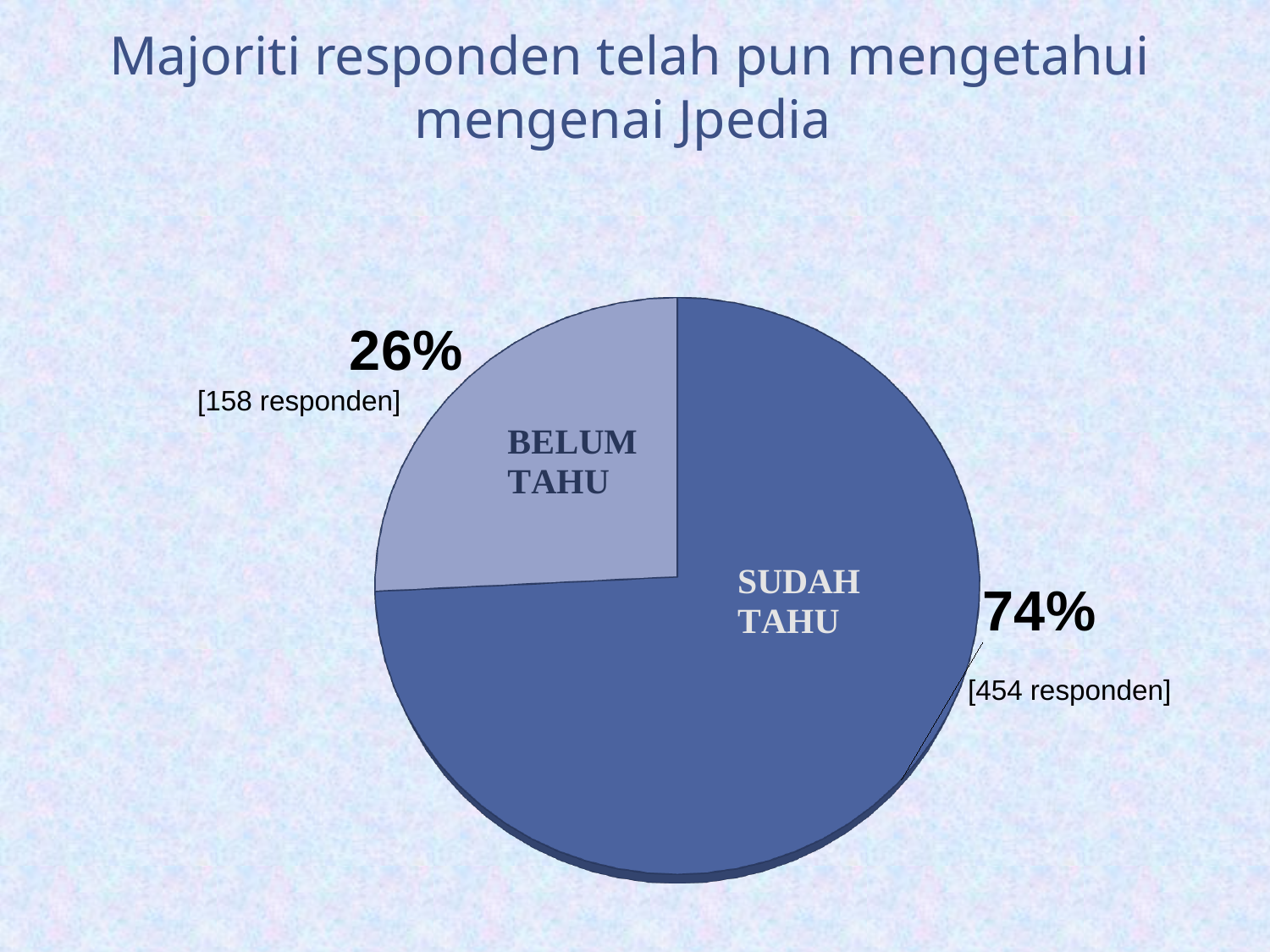
What is the difference in percentage points between the SUDAH TAHU and BELUM TAHU slices? 48 What is the title of the slide? Majoriti responden telah pun mengetahui mengenai Jpedia What kind of chart is shown on the slide? pie chart Which slice is the smallest? BELUM TAHU How many respondents are in the BELUM TAHU slice? 158 responden How many respondents are in the SUDAH TAHU slice? 454 responden What percentage of the pie is the BELUM TAHU slice? 26% How many slices does the pie chart have? 2 What percentage of the pie is the SUDAH TAHU slice? 74% Which slice is larger, SUDAH TAHU or BELUM TAHU? SUDAH TAHU Which slice is the largest? SUDAH TAHU What is the difference in number of respondents between SUDAH TAHU and BELUM TAHU? 296